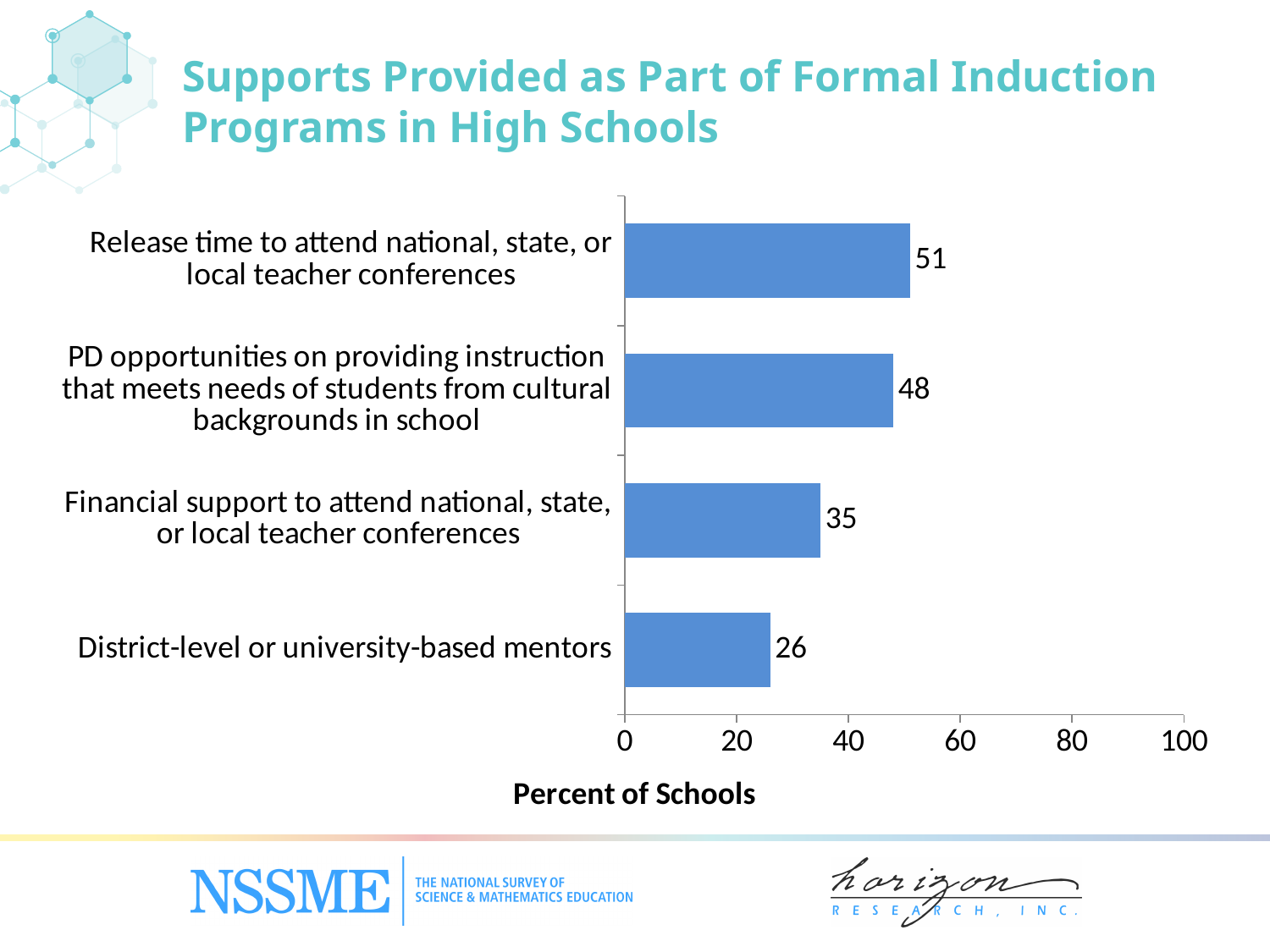
Which support has the lowest percent of schools? District-level or university-based mentors What percent of schools provide PD opportunities on providing instruction that meets needs of students from cultural backgrounds in school? 48 What is the difference in percent of schools between release time to attend teacher conferences and financial support to attend teacher conferences? 16 Which support has the highest percent of schools? Release time to attend national, state, or local teacher conferences Which is larger: the percent of schools providing financial support to attend teacher conferences or the percent providing district-level or university-based mentors? Financial support to attend national, state, or local teacher conferences What kind of chart is shown on the slide? Bar chart What percent of schools provide release time to attend national, state, or local teacher conferences? 51 Is the value for PD opportunities on providing instruction that meets needs of students from cultural backgrounds greater or less than 40? greater What percent of schools provide district-level or university-based mentors? 26 What is the label of the horizontal axis? Percent of Schools How many supports are shown in the chart? 4 What percent of schools provide financial support to attend national, state, or local teacher conferences? 35